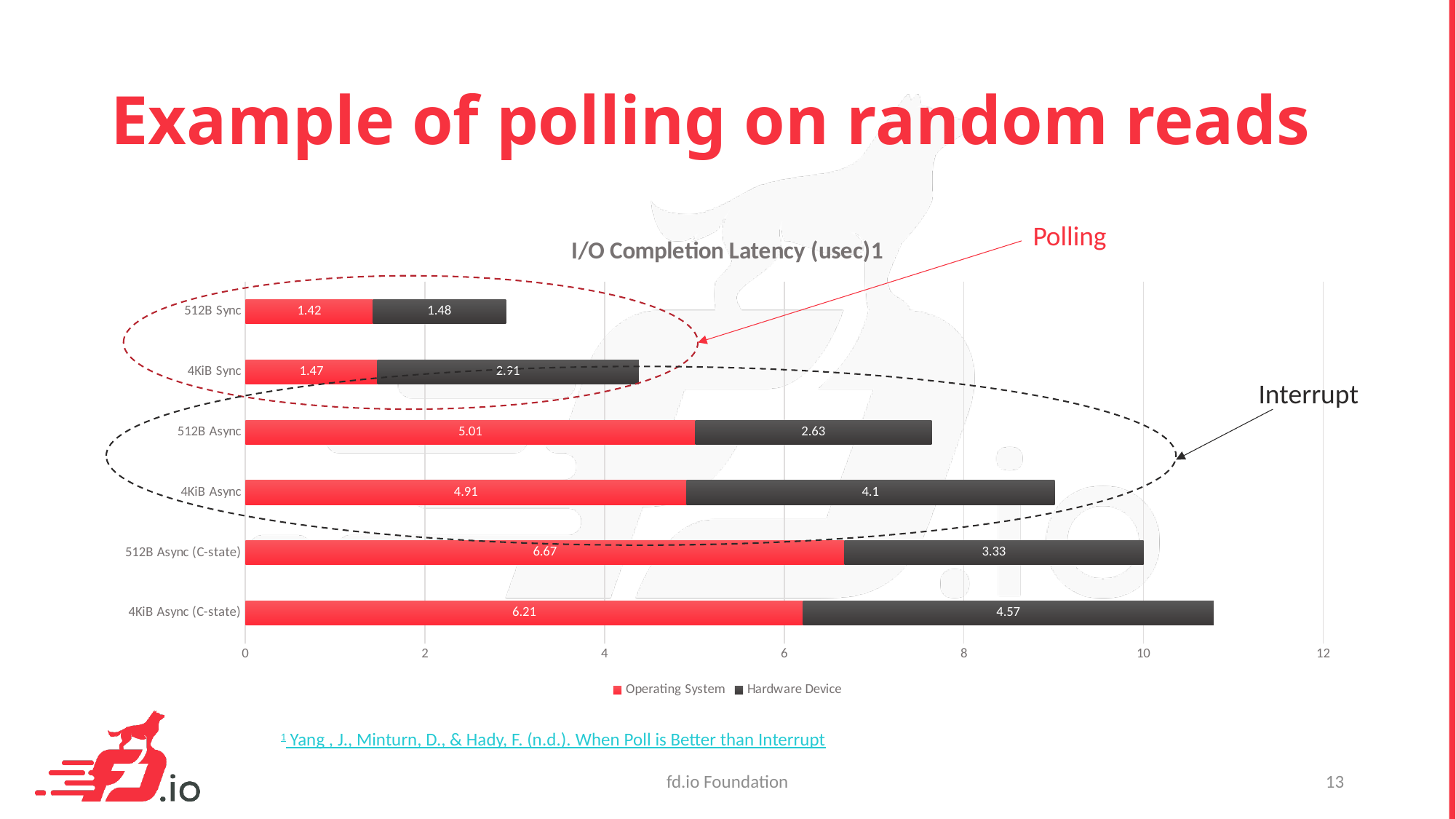
Which is larger: the Hardware Device value for 4KiB Async or the Hardware Device value for 512B Async? 4KiB Async How many series does the legend list? 2 What is the total stacked value for 512B Async (C-state)? 10 How many categories are shown on the chart? 6 What is the Hardware Device value for 4KiB Async (C-state)? 4.57 What is the Hardware Device value for 4KiB Sync? 2.91 What type of chart is shown on the slide? Stacked horizontal bar chart Which category has the highest Operating System value? 512B Async (C-state) What is the total stacked value for 512B Sync? 2.9 Which category has the lowest Hardware Device value? 512B Sync What is the difference between the Operating System values for 512B Async (C-state) and 4KiB Async (C-state)? 0.46 What is the Operating System value for 512B Async? 5.01